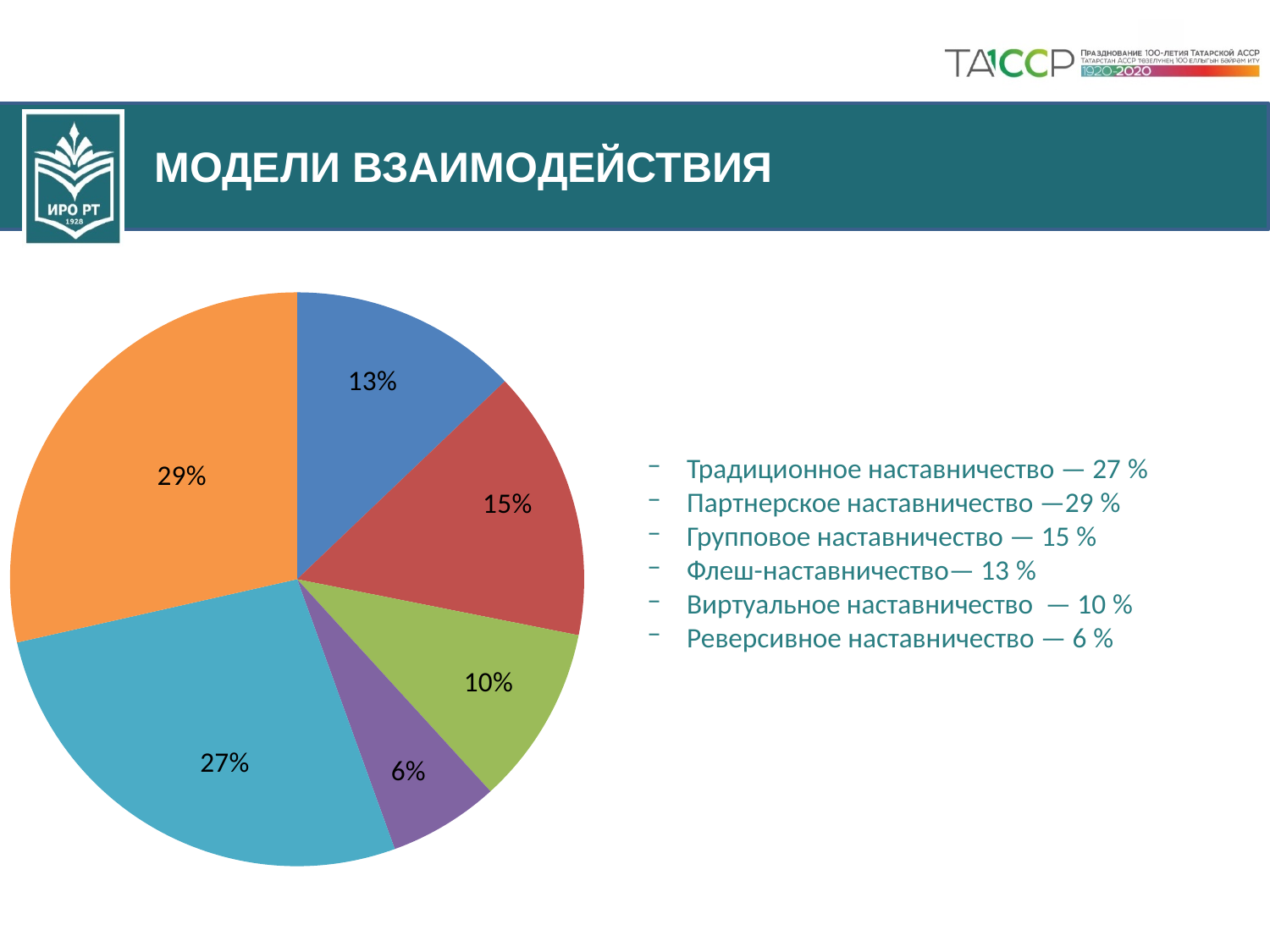
What is the difference between the values for Групповое наставничество and Реверсивное наставничество? 9% How many slices does the pie chart have? 6 What is the smallest value shown in the pie chart? 6% What share of the pie does Партнерское наставничество have? 29% What share of the pie does Реверсивное наставничество have? 6% Which is larger, the value for Групповое наставничество or the value for Виртуальное наставничество? Групповое наставничество What is the largest value shown in the pie chart? 29% What kind of chart is shown on the slide? pie chart What is the value for Флеш-наставничество? 13% What is the difference between the values for Партнерское наставничество and Традиционное наставничество? 2% What share of the pie does Традиционное наставничество have? 27% What is the title of the slide containing the pie chart? МОДЕЛИ ВЗАИМОДЕЙСТВИЯ